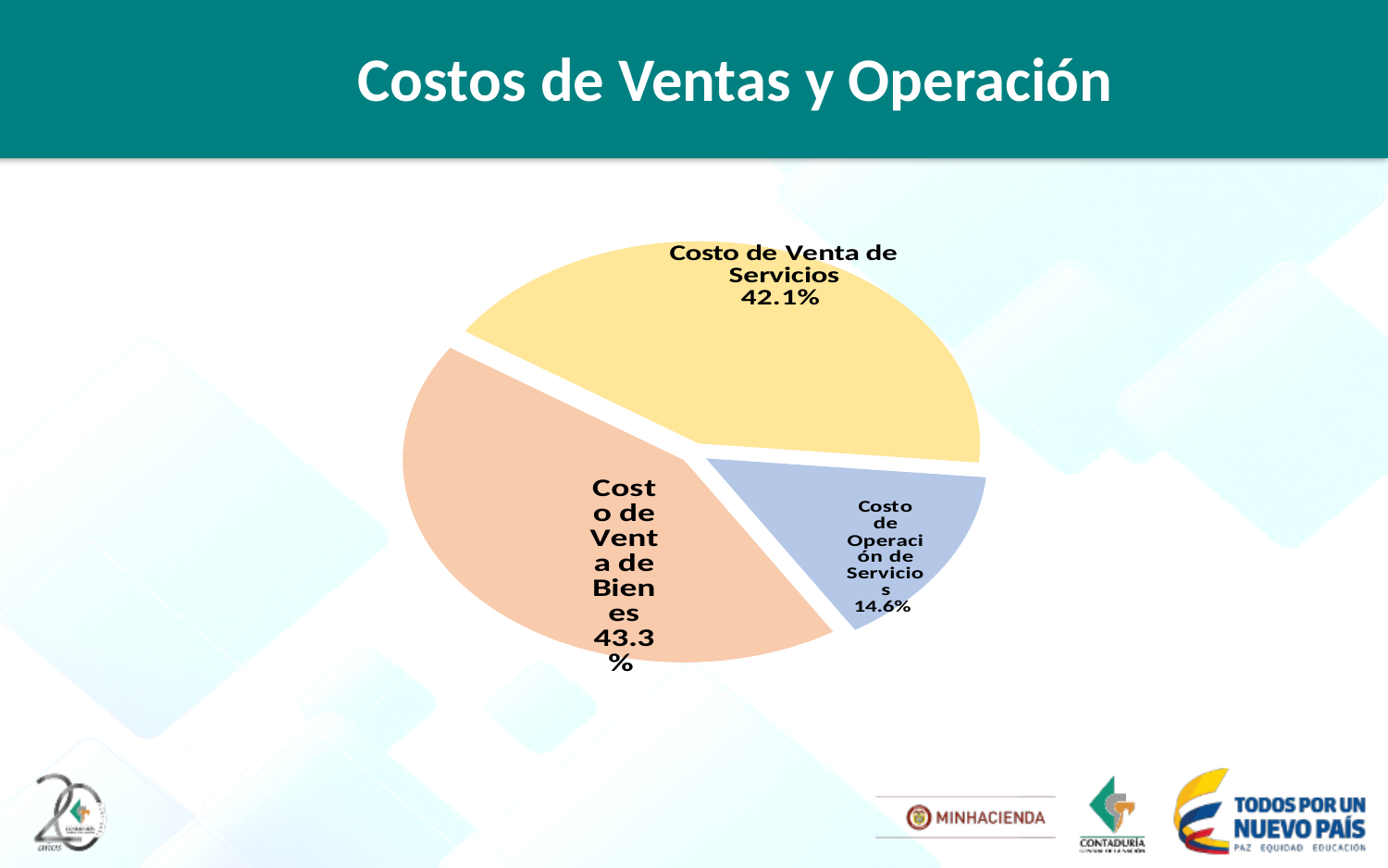
What is the difference in percentage points between Costo de Venta de Servicios and Costo de Operación de Servicios? 27.5 Which category has the largest share of the pie? Costo de Venta de Bienes How many slices does the pie chart have? 3 Which category has the smallest share of the pie? Costo de Operación de Servicios What share of the pie is Costo de Venta de Bienes? 43.3% What colour is the Costo de Venta de Servicios slice? yellow Which is larger, the share for Costo de Venta de Servicios or the share for Costo de Operación de Servicios? Costo de Venta de Servicios What is the difference in percentage points between Costo de Venta de Bienes and Costo de Venta de Servicios? 1.2 What kind of chart is shown on the slide? pie chart What share of the pie is Costo de Venta de Servicios? 42.1% What share of the pie is Costo de Operación de Servicios? 14.6% What is the title of the chart on the slide? Costos de Ventas y Operación